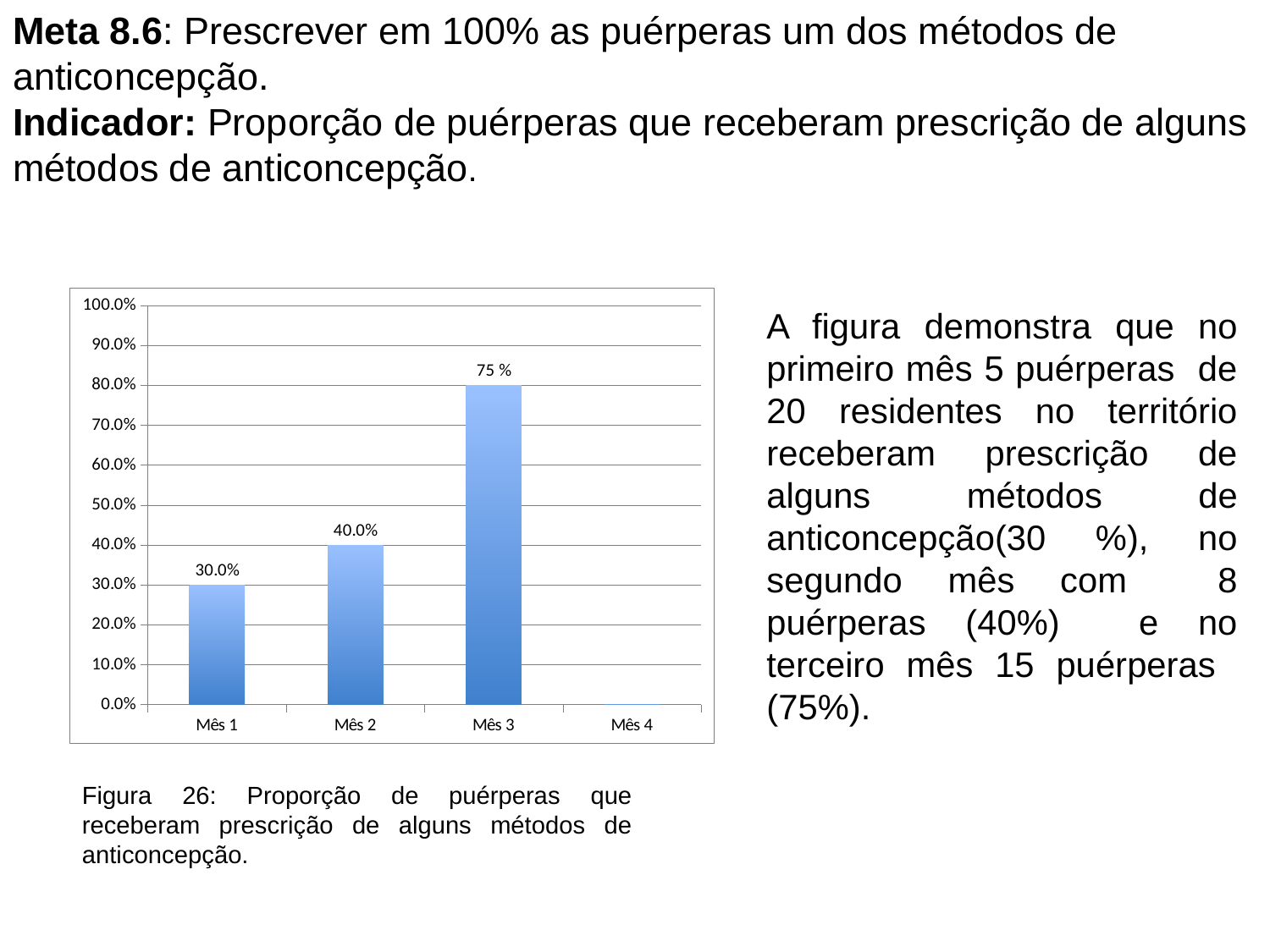
Which is larger, the value for Mês 2 or the value for Mês 1? Mês 2 What is the difference between the values for Mês 2 and Mês 1? 10.0% What is the value shown for Mês 1? 30.0% Is the value for Mês 3 greater or less than 70.0%? greater Do the values rise or fall from Mês 1 to Mês 3? Rise Which month has the highest bar? Mês 3 What data label is printed above the bar for Mês 3? 75 % What is the value shown for Mês 2? 40.0% Is the value for Mês 2 greater or less than 50.0%? less Among Mês 1, Mês 2 and Mês 3, which has the lowest value? Mês 1 What kind of chart is shown? Bar chart How many months are shown on the x axis? 4